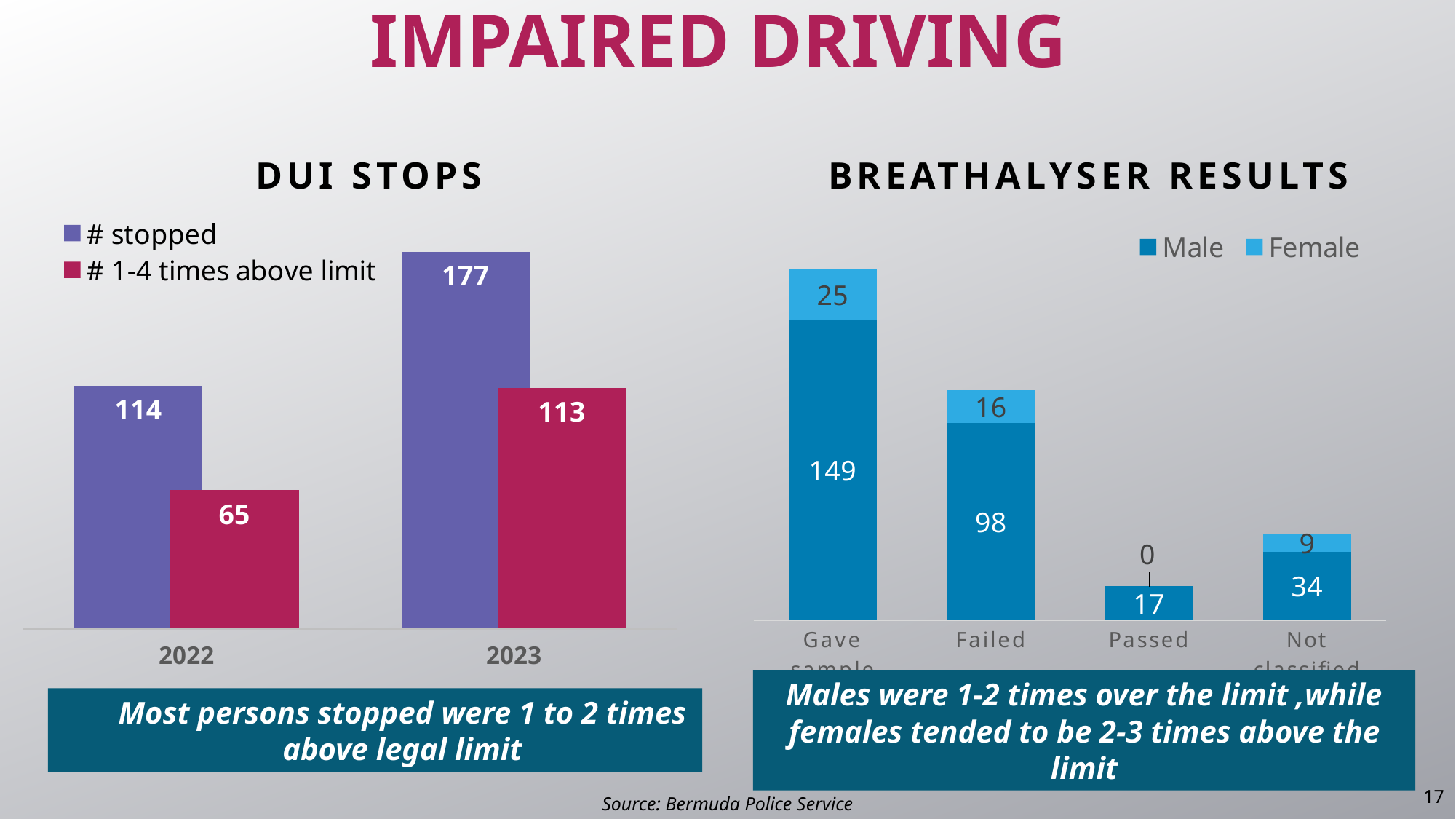
In the DUI Stops chart, how many persons were stopped in 2023? 177 In the DUI Stops chart, what is the value for # 1-4 times above limit in 2022? 65 In the Breathalyser Results chart, what is the Female value for Gave sample? 25 In the Breathalyser Results chart, which category has the lowest Male value? Passed In the Breathalyser Results chart, what is the Male value for Failed? 98 In the DUI Stops chart, what is the difference between the number stopped in 2023 and in 2022? 63 What kind of chart is the Breathalyser Results chart? Stacked bar chart In the Breathalyser Results chart, what is the total of the Not classified bar? 43 In the Breathalyser Results chart, how many categories are shown on the x axis? 4 In the DUI Stops chart, which year has the higher value for # 1-4 times above limit? 2023 In the DUI Stops chart, how many series does the legend list? 2 In the Breathalyser Results chart, what is the total of the Passed bar? 17